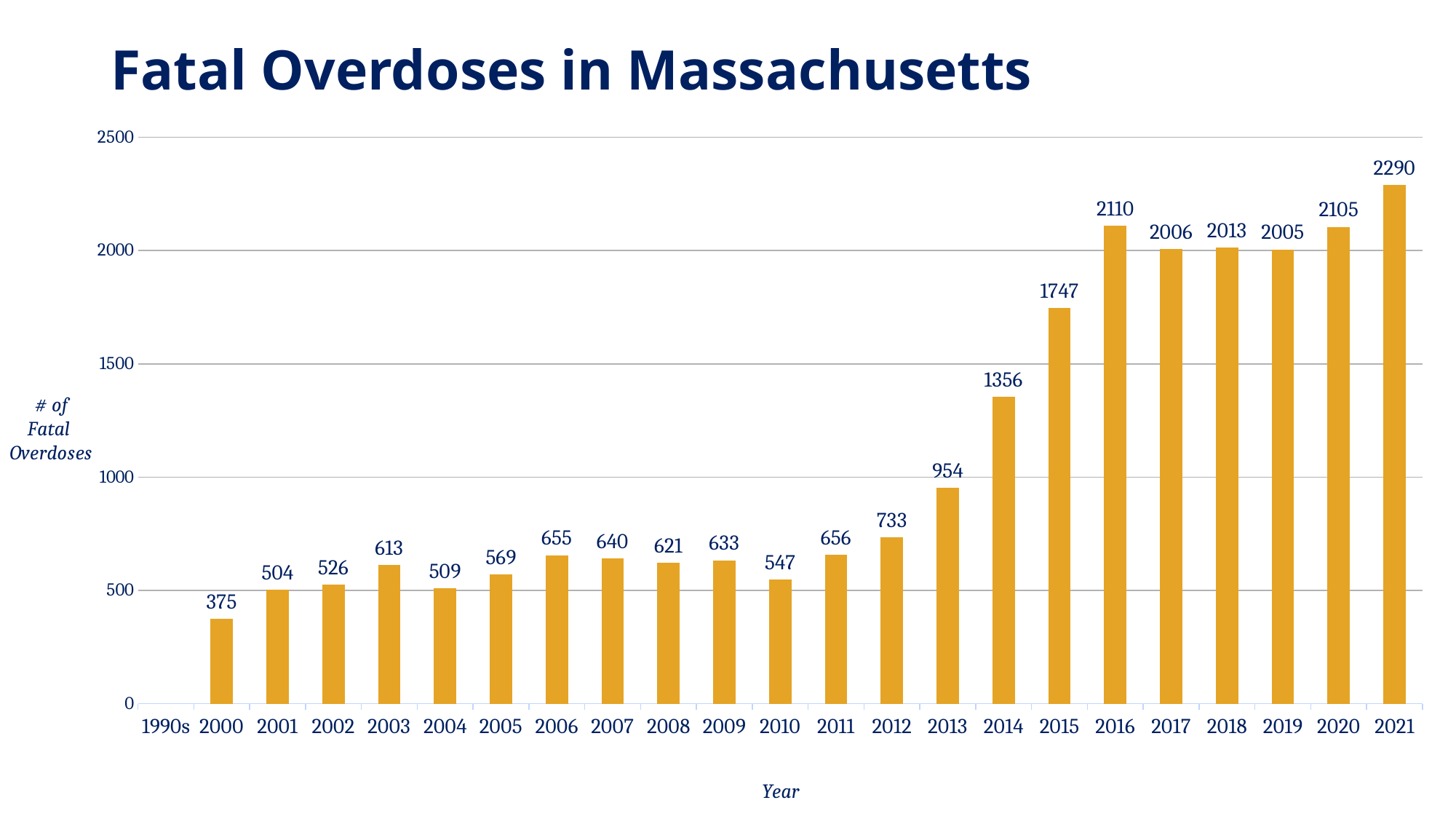
What is the difference in fatal overdoses between 2021 and 2020? 185 Is the value for 2015 greater or less than 1500? greater What is the title of the chart? Fatal Overdoses in Massachusetts Which year has the highest number of fatal overdoses? 2021 What is the number of fatal overdoses in 2016? 2110 Which year had more fatal overdoses, 2013 or 2012? 2013 What is the difference in fatal overdoses between 2015 and 2014? 391 What kind of chart is shown on the slide? Bar chart What is the number of fatal overdoses in 2014? 1356 Do the values generally rise or fall from 2013 to 2016? Rise What is the number of fatal overdoses in 2000? 375 Which year with a bar shown has the lowest number of fatal overdoses? 2000